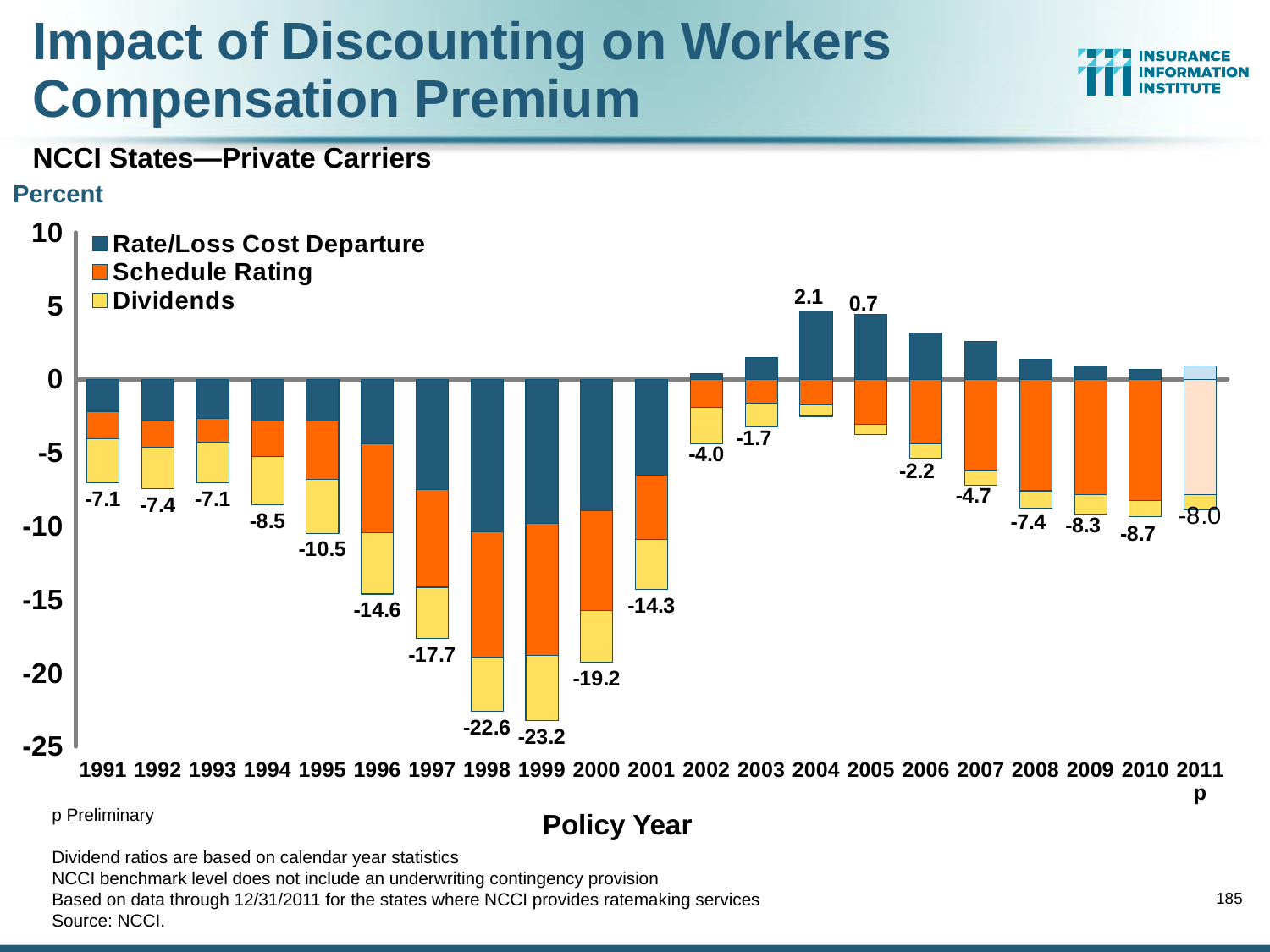
What is the labeled value for policy year 1999? -23.2 How many series does the legend list? 3 How many policy years are shown on the x axis? 21 Which policy year has the highest labeled value? 2004 What is the labeled value for policy year 2004? 2.1 What type of chart is shown on the slide? bar chart Which legend entry is shown in yellow? Dividends Which policy year has the higher labeled value, 2000 or 2001? 2001 What is the labeled value for policy year 2011p? -8.0 What is the difference between the labeled values for 1998 and 1999? 0.6 Which policy year has the lowest labeled value? 1999 Do the labeled values rise or fall from 1991 to 1999? fall